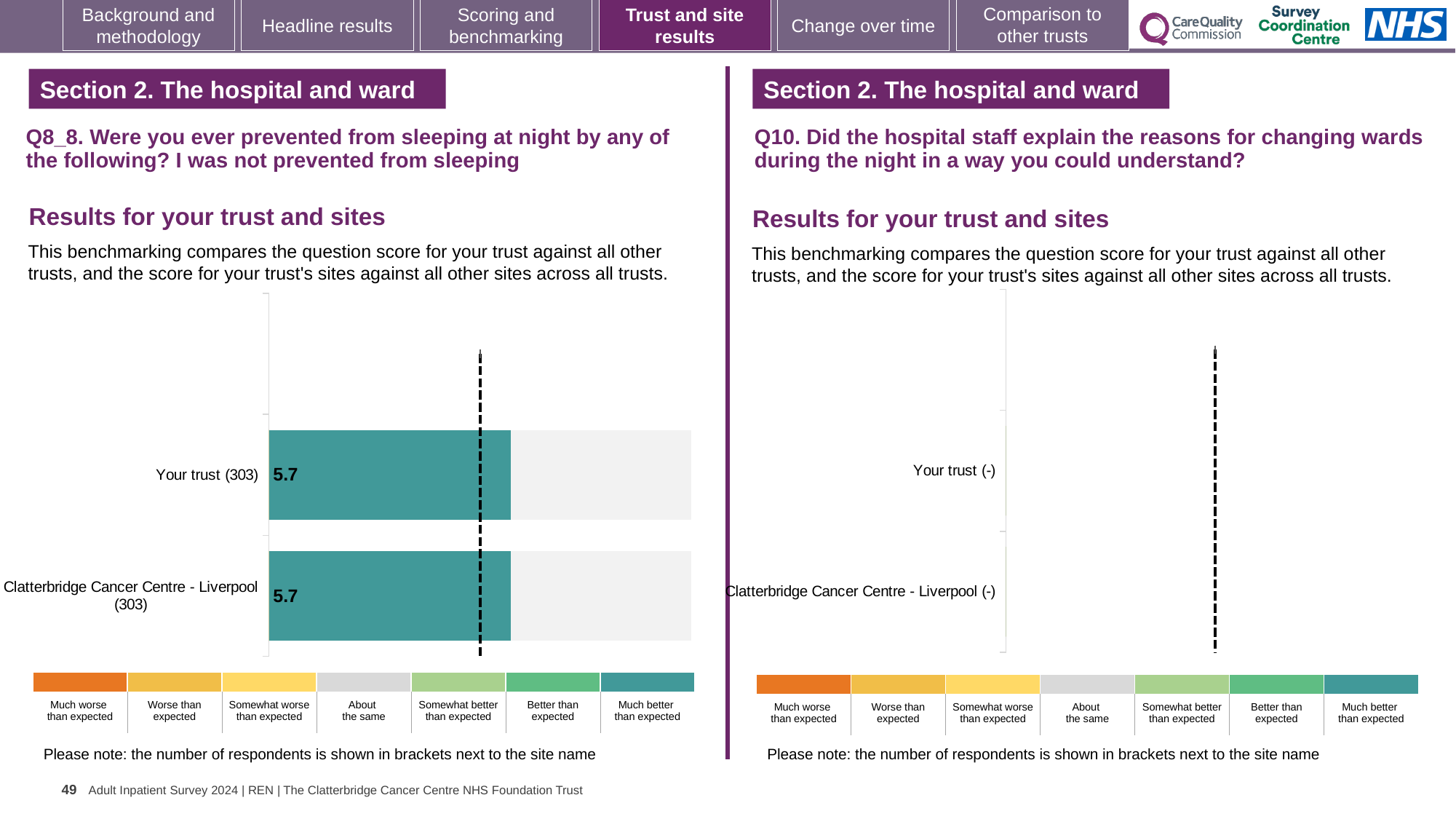
On the left chart (Q8_8), how many respondents are shown in brackets for Your trust? 303 On the left chart (Q8_8), which benchmark category does the colour of the bars correspond to? Much better than expected On the left chart (Q8_8), is the score for Your trust the same as the score for Clatterbridge Cancer Centre - Liverpool? Yes What kind of chart is shown on the left side of the slide (Q8_8)? Bar chart On the left chart (Q8_8), what is the score for Clatterbridge Cancer Centre - Liverpool? 5.7 On the left chart (Q8_8), how many bars are plotted? 2 How many benchmark categories are shown in the colour key below the left chart (Q8_8)? 7 On the left chart (Q8_8), what is the score for Your trust? 5.7 On the right chart (Q10), how many bars are plotted with a score? 0 On the right chart (Q10), how many respondents are shown in brackets for Your trust? - On the left chart (Q8_8), what is the difference between the score for Your trust and the score for Clatterbridge Cancer Centre - Liverpool? 0